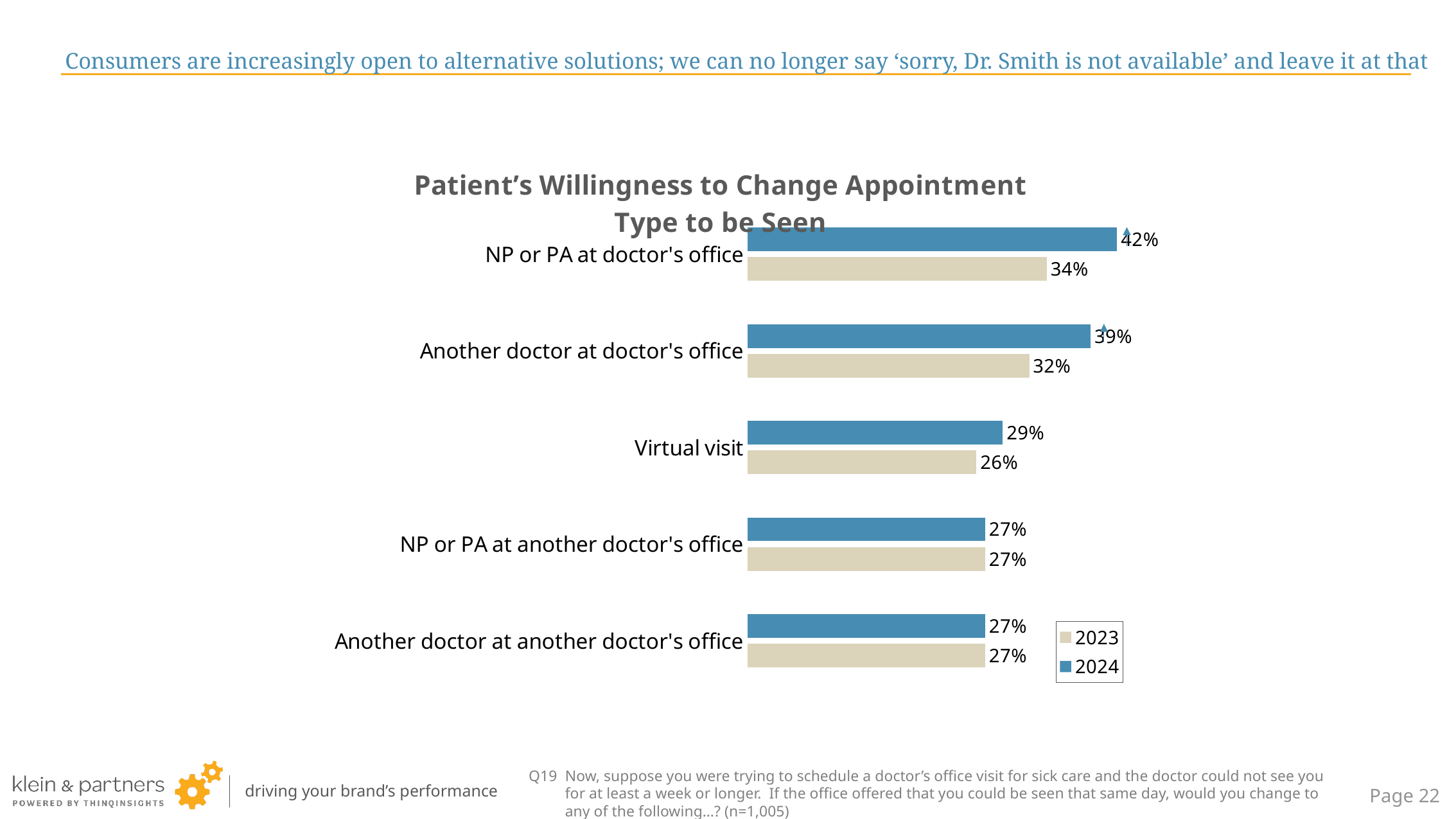
What is the 2023 value for Virtual visit? 26% How many series does the legend list? 2 Which category has the lowest 2023 value? Virtual visit What is the difference between the 2024 and 2023 values for Another doctor at doctor's office? 7% Which is larger for Virtual visit, the 2024 value or the 2023 value? 2024 What is the 2023 value for Another doctor at doctor's office? 32% How many categories are shown in the chart? 5 What is the title of the chart? Patient's Willingness to Change Appointment Type to be Seen Which category has the highest 2024 value? NP or PA at doctor's office What kind of chart is shown on the slide? Bar chart What is the difference between the 2024 and 2023 values for NP or PA at doctor's office? 8% What is the 2024 value for NP or PA at doctor's office? 42%